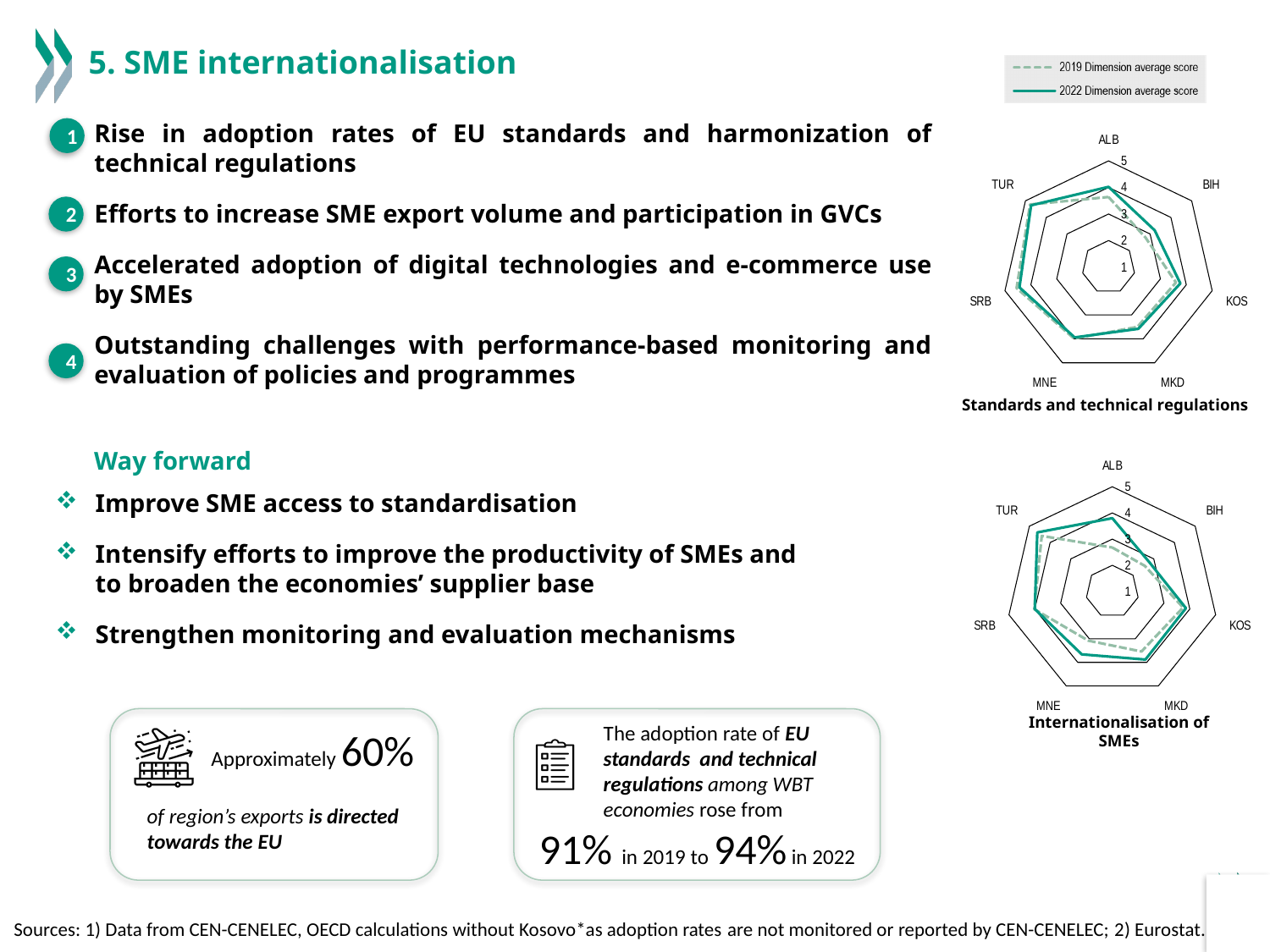
In the 'Internationalisation of SMEs' chart, is the 2022 value for BIH greater or less than 4? less In the 'Internationalisation of SMEs' chart, which has the larger 2022 value, SRB or BIH? SRB In the 'Standards and technical regulations' chart, is the 2022 value for TUR greater or less than 4? greater In the 'Standards and technical regulations' chart, which has the larger 2022 value, TUR or KOS? TUR In the 'Internationalisation of SMEs' chart, is the 2022 value for SRB greater or less than 3? greater What is the title of the lower radar chart? Internationalisation of SMEs What is the maximum value shown on the axis scale of the 'Standards and technical regulations' radar chart? 5 What kind of chart is the 'Standards and technical regulations' chart? Radar chart How many series does the legend list for the radar charts? 2 Which series is drawn with a dashed line in the radar charts? 2019 Dimension average score How many economies are plotted on the 'Internationalisation of SMEs' chart? 7